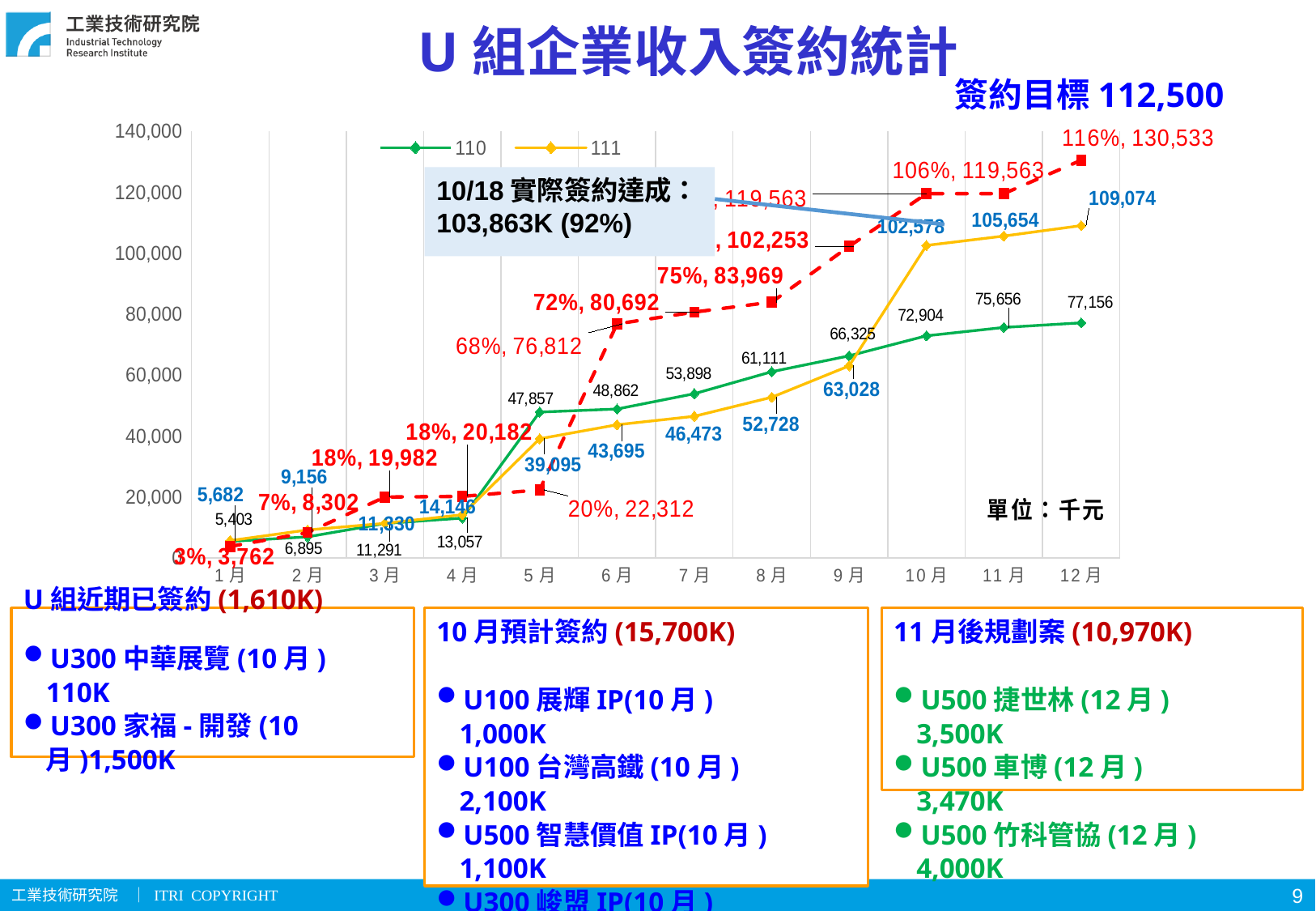
What is the value of series 110 in 12月? 77,156 In which month does series 111 reach its highest value? 12月 In which month is series 110 at its lowest value? 1月 What kind of chart is shown on the slide? line chart How many series does the legend list? 2 What is the difference between series 111 and series 110 in 12月? 31,918 What is the value of series 110 in 5月? 47,857 What is the value of series 111 in 10月? 102,578 By how much did series 110 increase from 9月 to 10月? 6,579 What is the 簽約目標 (contract target) stated on the slide? 112,500 In 5月, which series has the larger value, 110 or 111? 110 How many months are shown on the x axis? 12